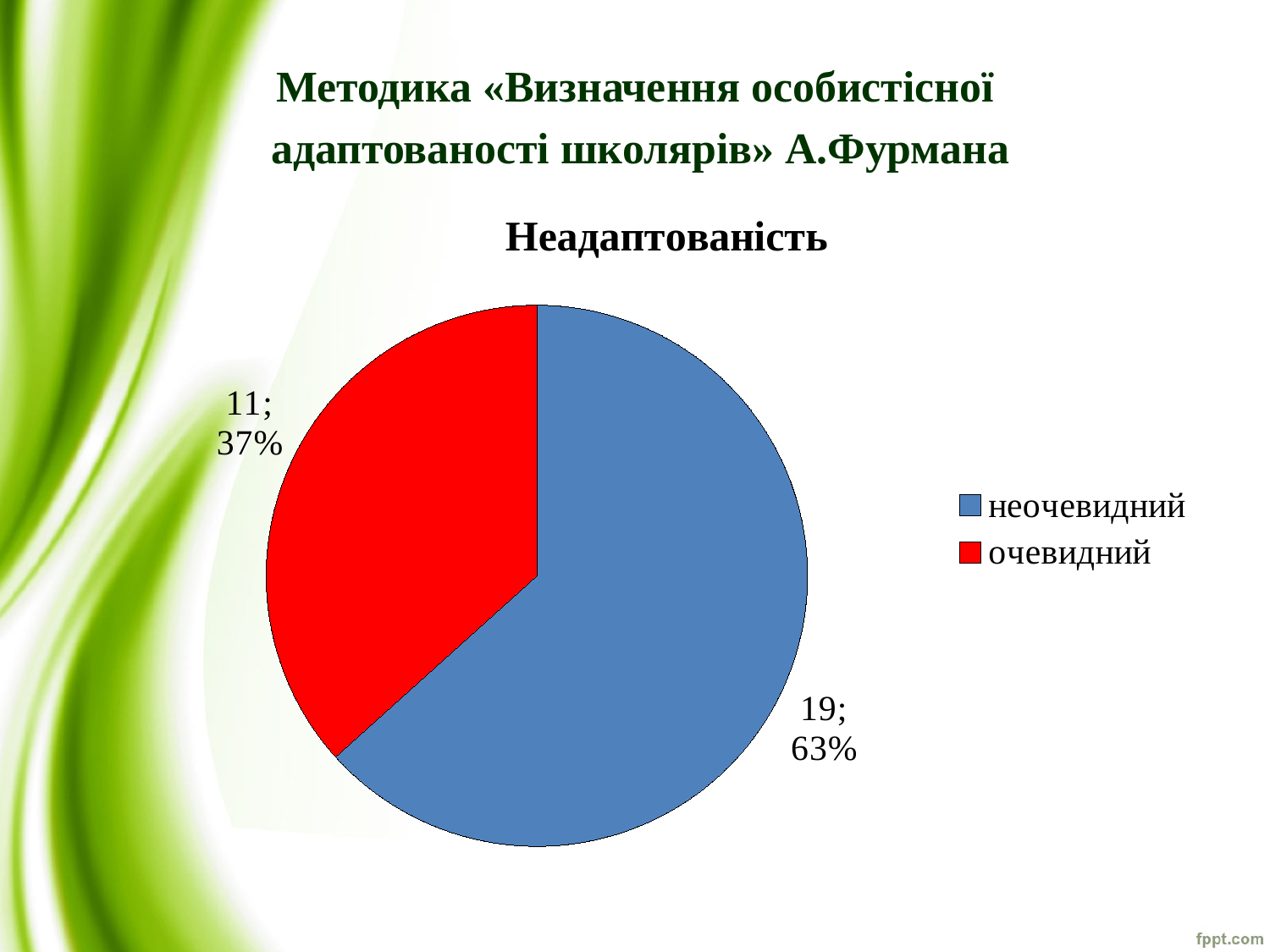
What share of the pie does очевидний represent? 37% What share of the pie does неочевидний represent? 63% Which colour represents очевидний in the chart? red What is the difference between the values for неочевидний and очевидний? 8 Which category has the smallest slice? очевидний How many entries does the legend list? 2 What is the value for неочевидний? 19 Which category has the largest slice? неочевидний What is the title of the chart? Неадаптованість What is the value for очевидний? 11 What type of chart is shown on the slide? pie chart How many slices does the pie chart have? 2